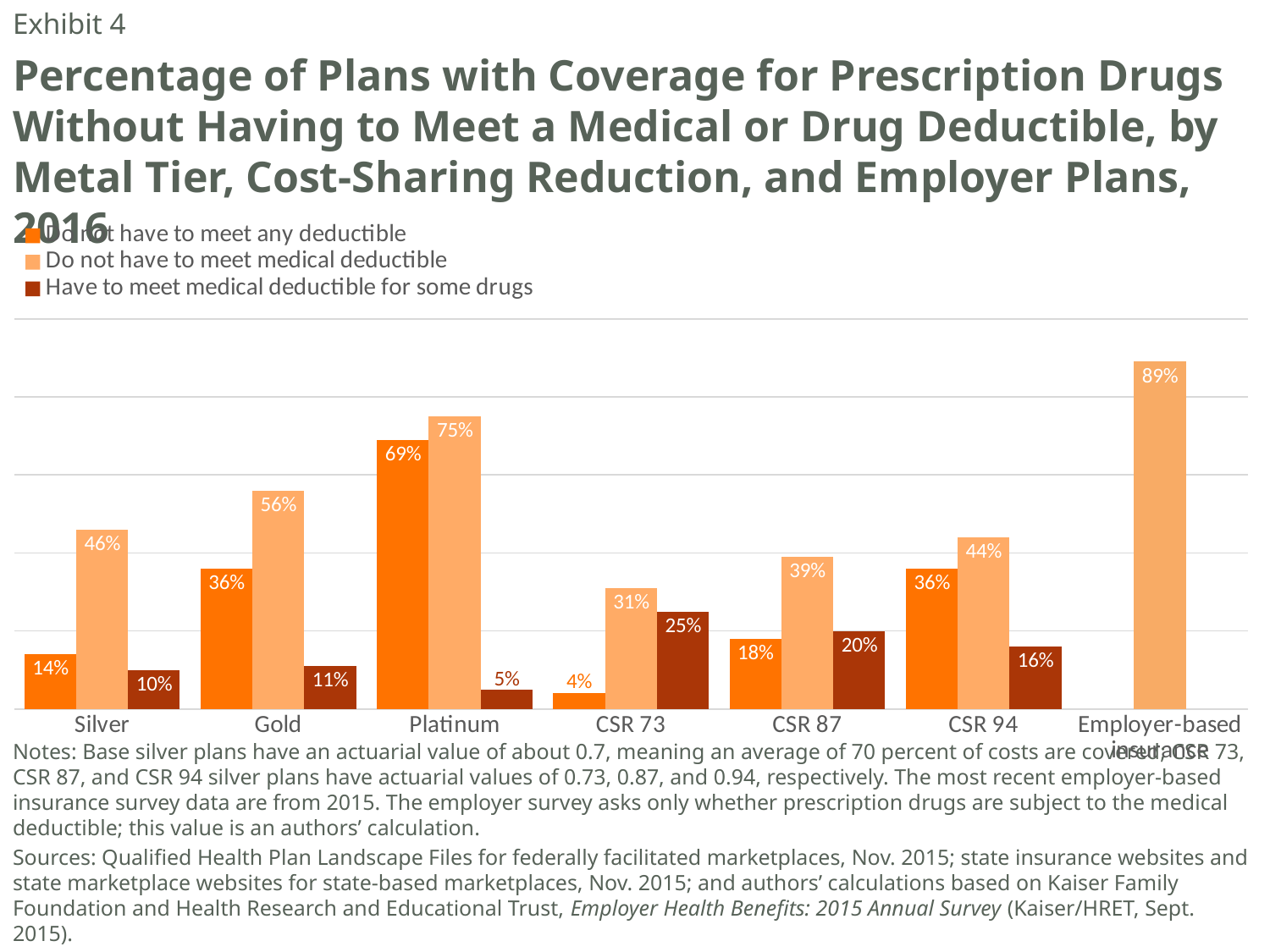
What is the value for Platinum plans that do not have to meet any deductible? 69% Which series is shown in the darkest (brown-red) colour? Have to meet medical deductible for some drugs How many series does the legend list? 3 How many categories are shown on the x axis? 7 Which category has the highest value for 'Do not have to meet medical deductible'? Employer-based Which category has the lowest value for 'Do not have to meet any deductible'? CSR 73 What type of chart is shown on the slide? bar chart What percentage of CSR 73 plans have to meet medical deductible for some drugs? 25% What is the difference between the 'Do not have to meet medical deductible' values for Gold and Silver? 10% Which is larger for CSR 87: 'Do not have to meet any deductible' or 'Have to meet medical deductible for some drugs'? Have to meet medical deductible for some drugs What is the value shown for Employer-based plans? 89% What percentage of Silver plans do not have to meet medical deductible? 46%